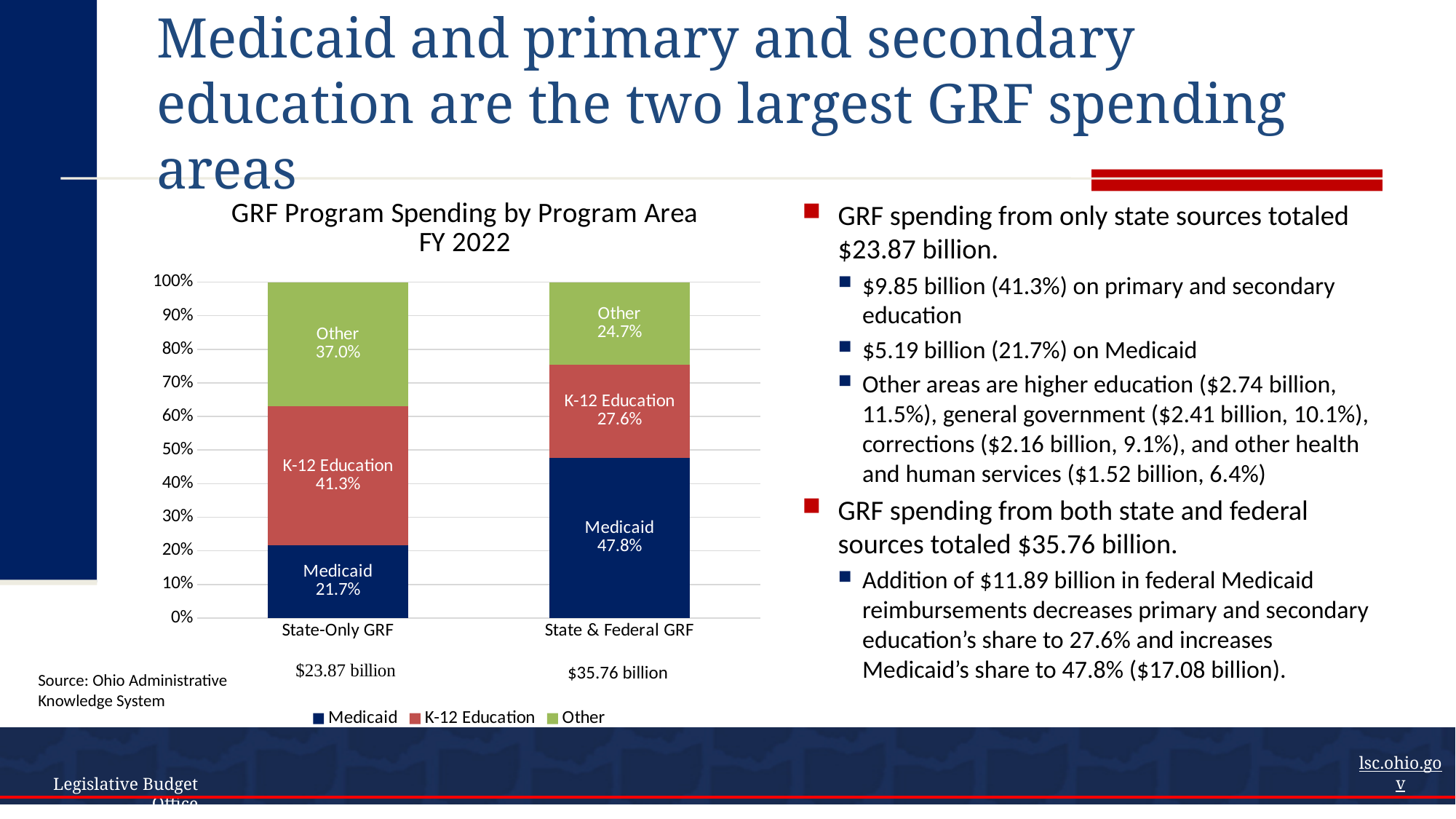
How many series does the legend list? 3 What is the difference between the Medicaid share in State & Federal GRF and in State-Only GRF? 26.1% What kind of chart is shown on the slide? Stacked bar chart Is the K-12 Education share larger in State-Only GRF or in State & Federal GRF? State-Only GRF What is the K-12 Education share of State & Federal GRF spending? 27.6% Which program area has the largest share in the State-Only GRF bar? K-12 Education What is the Other share of State-Only GRF spending? 37.0% What is the title of the chart? GRF Program Spending by Program Area FY 2022 What is the Medicaid share of State-Only GRF spending? 21.7% How many bars (categories) are shown on the x axis? 2 Which program area has the smallest share in the State & Federal GRF bar? Other What is the Medicaid share of State & Federal GRF spending? 47.8%